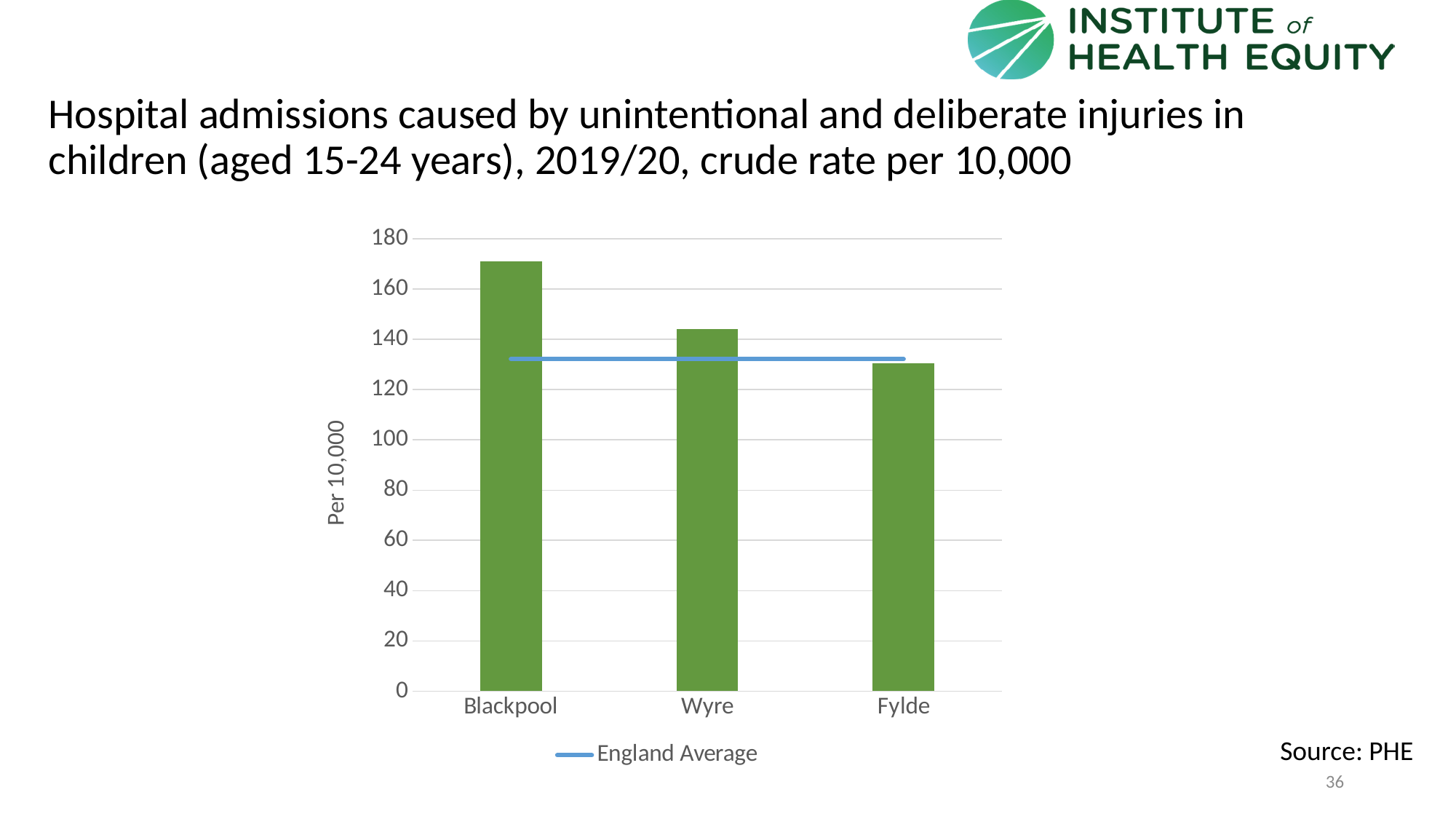
Which has a higher admission rate, Blackpool or Wyre? Blackpool Is the value for Fylde greater or less than 140? less Is the value for Wyre greater or less than 160? less What does the horizontal blue line on the chart represent? England Average What kind of chart is shown on the slide? Combination bar and line chart Which area has the lowest hospital admission rate on the chart? Fylde Which area has the highest hospital admission rate on the chart? Blackpool Which has a higher admission rate, Wyre or Fylde? Wyre How many entries does the chart legend list? 1 Do the bar values rise or fall moving from Blackpool to Fylde along the x axis? Fall Is the value for Blackpool greater or less than 160? greater How many areas are shown as bars on the chart? 3